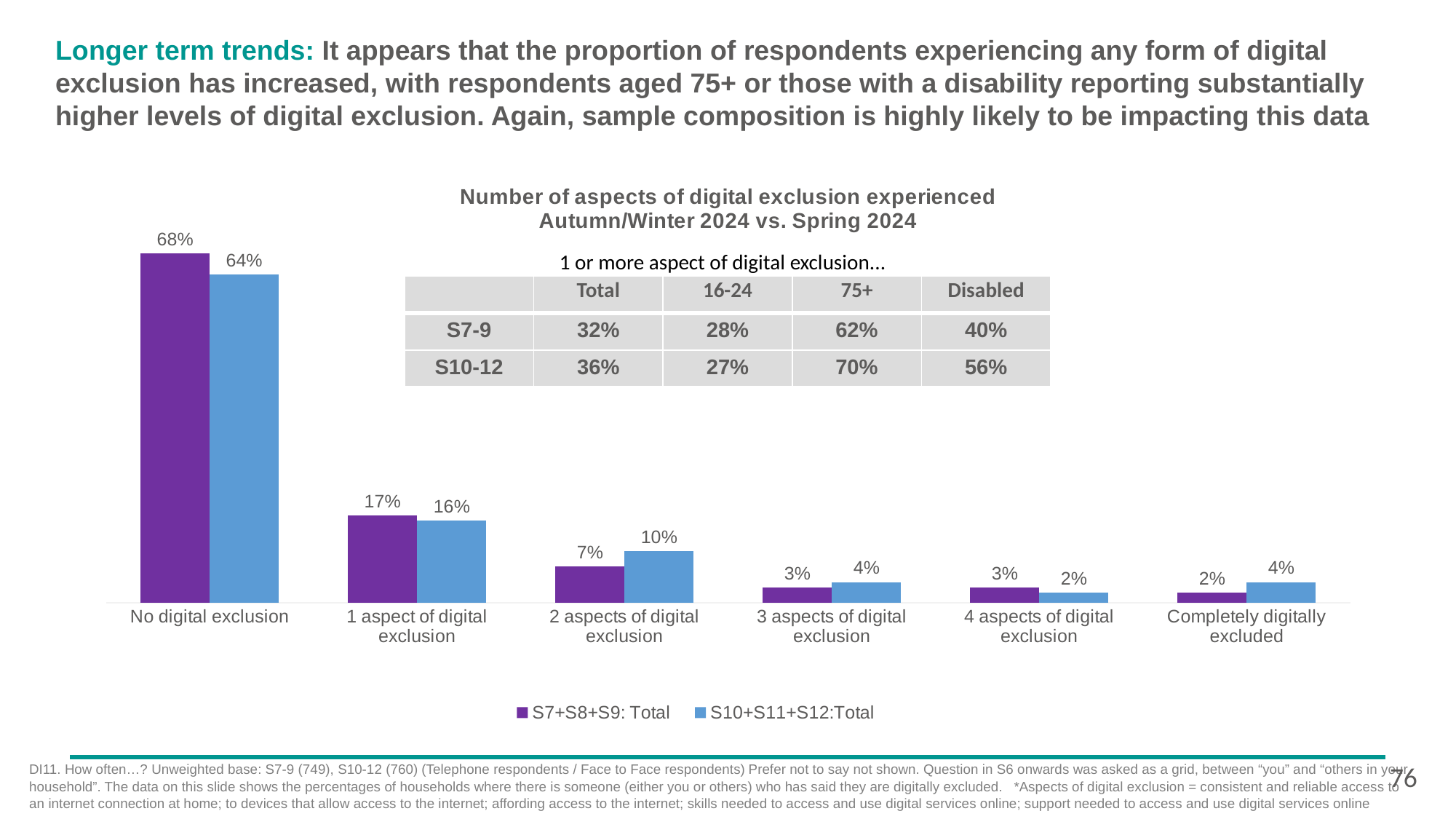
How many categories are shown on the x axis of the chart? 6 What is the value for 'No digital exclusion' in the S7+S8+S9: Total series? 68% What is the difference between the S7+S8+S9: Total and S10+S11+S12:Total values for 'No digital exclusion'? 4% What is the difference between the S7+S8+S9: Total and S10+S11+S12:Total values for '1 aspect of digital exclusion'? 1% How many series does the chart legend list? 2 What is the value for 'Completely digitally excluded' in the S7+S8+S9: Total series? 2% Which series has the larger value for '4 aspects of digital exclusion', S7+S8+S9: Total or S10+S11+S12:Total? S7+S8+S9: Total What kind of chart is shown on the slide? Bar chart What is the title of the chart? Number of aspects of digital exclusion experienced Autumn/Winter 2024 vs. Spring 2024 Which category has the highest value in the S10+S11+S12:Total series? No digital exclusion Which series has the larger value for '2 aspects of digital exclusion', S7+S8+S9: Total or S10+S11+S12:Total? S10+S11+S12:Total What is the value for '2 aspects of digital exclusion' in the S10+S11+S12:Total series? 10%